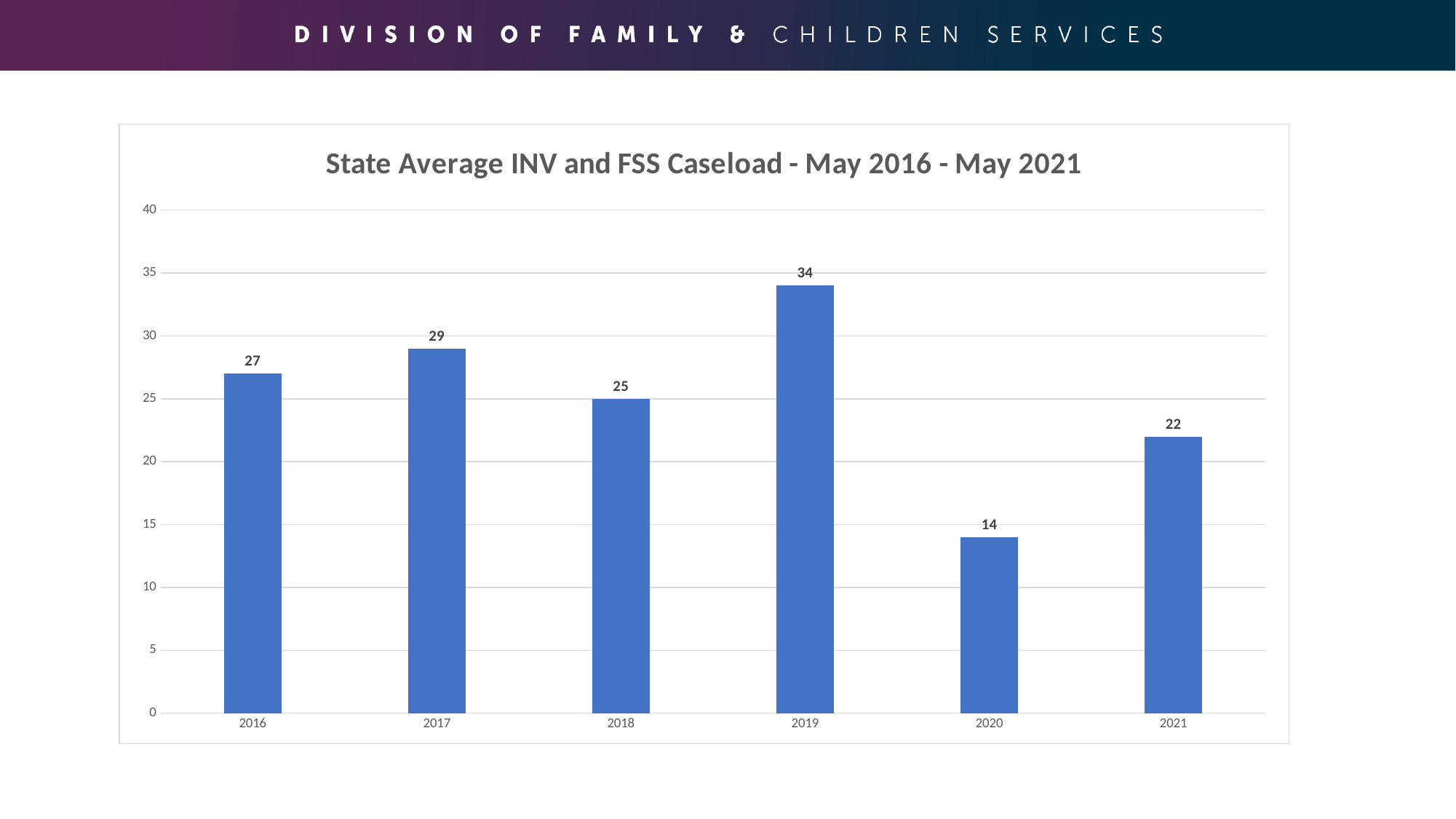
What is the difference between the 2017 and 2018 values? 4 What kind of chart is shown on the slide? Bar chart Which is larger, the value for 2016 or the value for 2021? 2016 What is the state average INV and FSS caseload for 2019? 34 How many years are shown on the x axis? 6 What is the state average INV and FSS caseload for 2020? 14 Which year has the highest state average caseload? 2019 What is the difference between the 2019 and 2020 values? 20 Is the value for 2021 greater or less than 25? less What is the title of the chart? State Average INV and FSS Caseload - May 2016 - May 2021 Which year has the lowest state average caseload? 2020 What is the value shown for 2016? 27